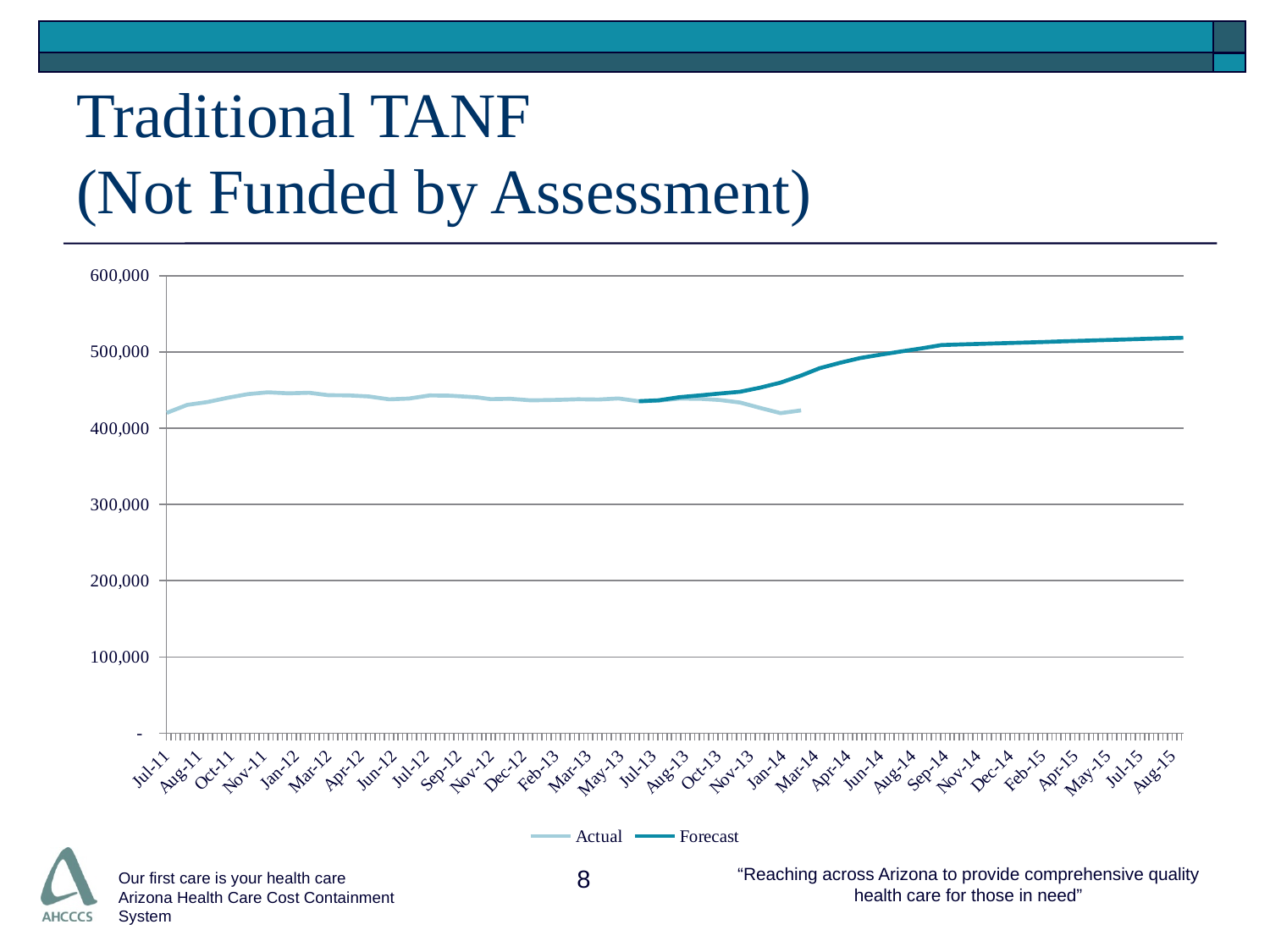
What are the two series named in the legend? Actual and Forecast Which is larger: the Forecast value at Aug-15 or the Actual value at Jan-14? Forecast at Aug-15 Is the Actual value for Jul-11 greater or less than 400,000? greater Is the Actual value for Jan-14 greater or less than 500,000? less Does the Forecast line rise or fall from Jul-13 to Aug-15? rise Is the Forecast value for Jul-13 greater or less than 500,000? less What kind of chart is shown on the slide? line chart How many series does the legend list? 2 What is the title of the slide containing the chart? Traditional TANF (Not Funded by Assessment) Which series reaches the highest value on the chart? Forecast